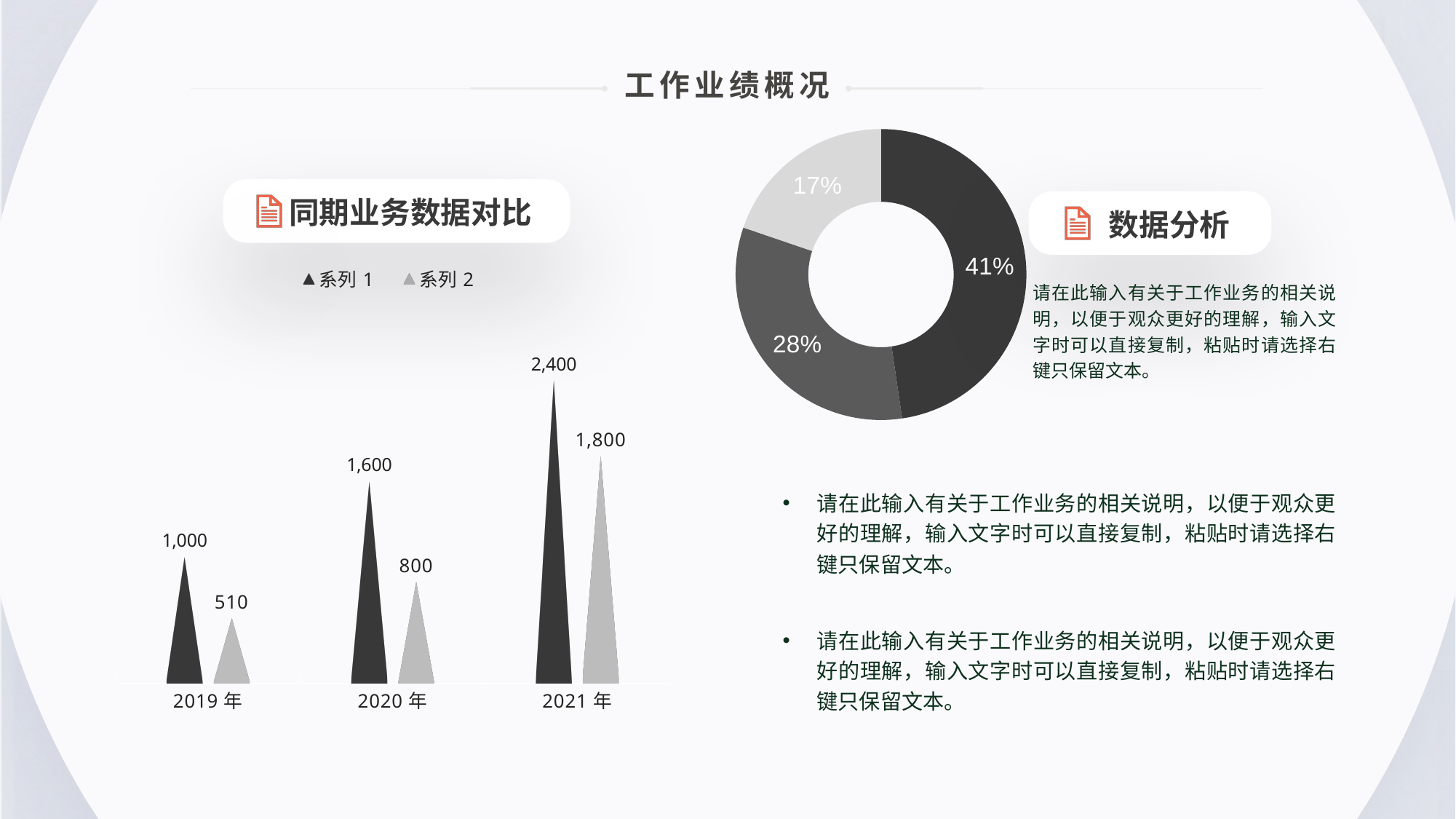
In the doughnut chart on the right, what percentage is shown on the largest slice? 41% In the bar chart titled 同期业务数据对比, what is the difference between 系列 1 and 系列 2 for 2021 年? 600 In the bar chart titled 同期业务数据对比, which year has the highest value for 系列 1? 2021 年 In the bar chart titled 同期业务数据对比, what is the value of 系列 1 for 2019 年? 1,000 In the bar chart titled 同期业务数据对比, which is larger for 2020 年: 系列 1 or 系列 2? 系列 1 What kind of chart is the chart on the right of the slide? doughnut chart In the bar chart titled 同期业务数据对比, do the values of 系列 1 rise or fall from 2019 年 to 2021 年? rise In the bar chart titled 同期业务数据对比, how many years are shown on the x axis? 3 In the bar chart titled 同期业务数据对比, how many series does the legend list? 2 In the bar chart titled 同期业务数据对比, what is the value of 系列 2 for 2021 年? 1,800 In the bar chart titled 同期业务数据对比, which year has the lowest value for 系列 2? 2019 年 In the bar chart titled 同期业务数据对比, what is the value of 系列 2 for 2020 年? 800